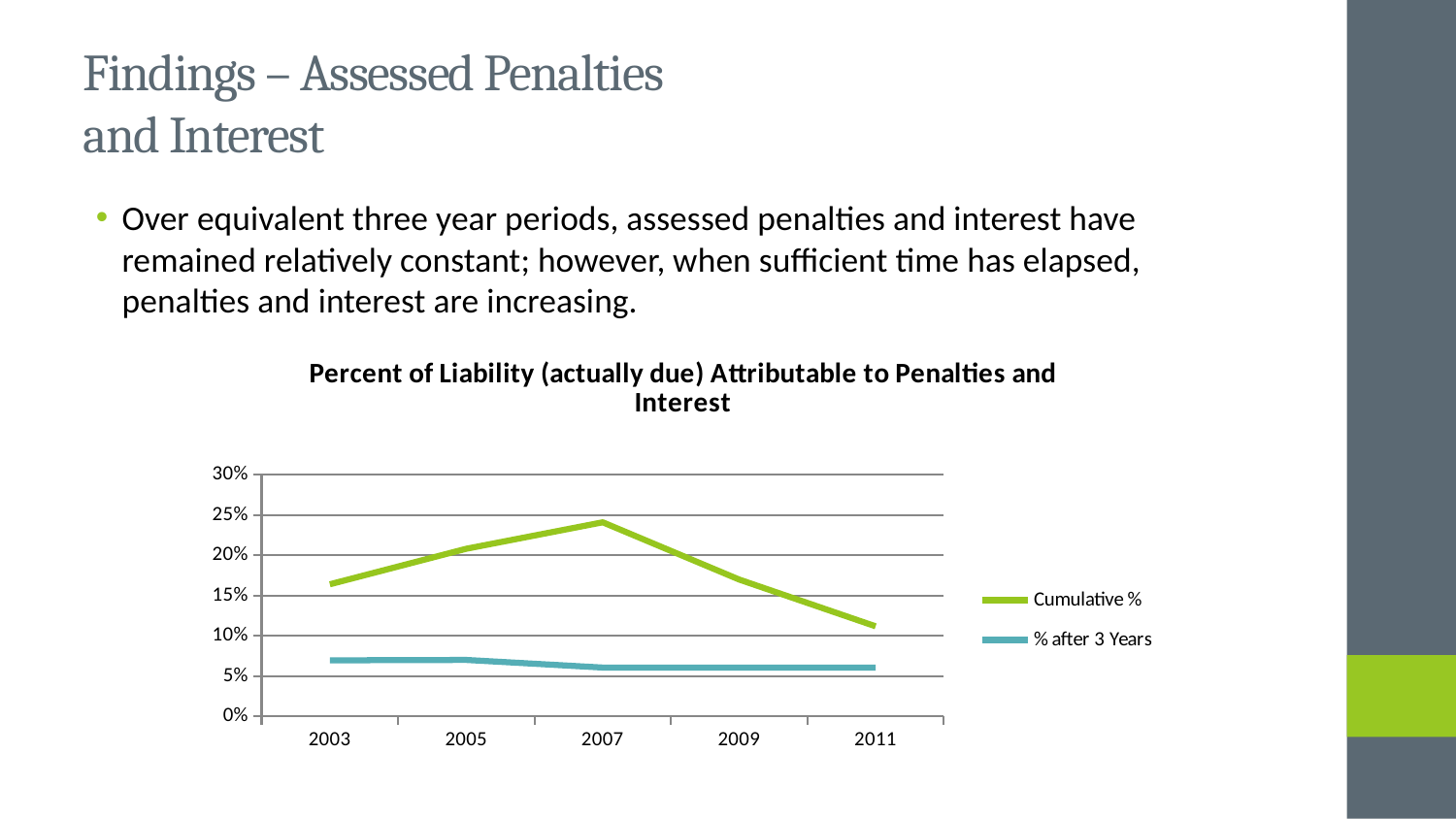
In which year is the Cumulative % lowest? 2011 Does the Cumulative % rise or fall from 2007 to 2011? Fall How many series does the legend list? 2 How many years are shown on the x axis? 5 Which is larger, the Cumulative % for 2005 or the Cumulative % for 2011? 2005 Which series has the higher value in 2009, Cumulative % or % after 3 Years? Cumulative % Is the Cumulative % value for 2011 greater or less than 15%? less What is the title of the chart? Percent of Liability (actually due) Attributable to Penalties and Interest Is the % after 3 Years value for 2003 greater or less than 10%? less In which year is the Cumulative % highest? 2007 What kind of chart is shown on the slide? Line chart Is the Cumulative % value for 2007 greater or less than 20%? greater